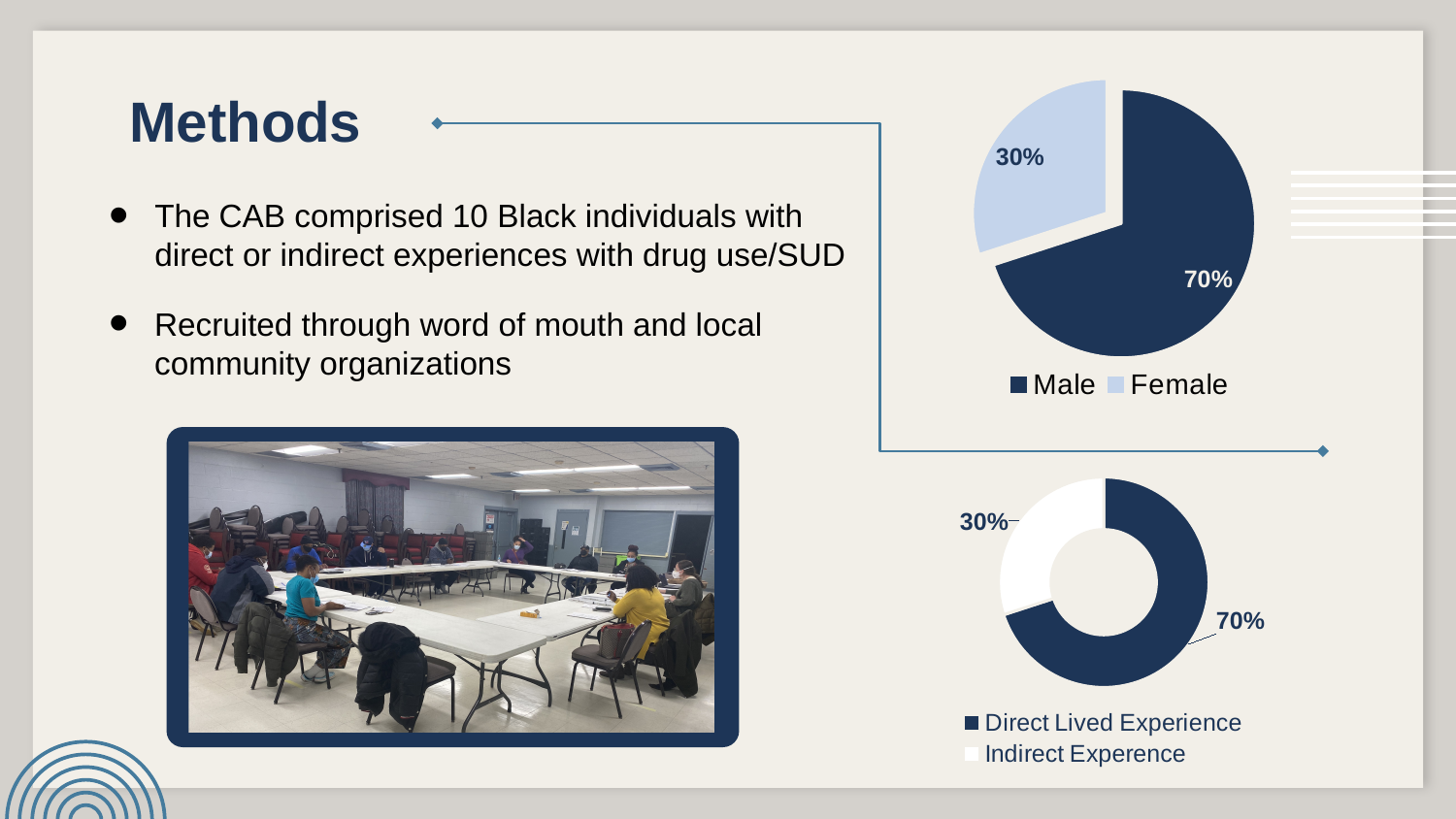
What kind of chart is shown in the bottom-right of the slide? Doughnut chart In the top-right pie chart, what percentage is labelled for Male? 70% How many categories does the bottom-right doughnut chart show? 2 In the top-right pie chart, what percentage is labelled for Female? 30% In the bottom-right doughnut chart, what percentage is labelled for Indirect Experence? 30% In the top-right pie chart, what is the difference in percentage points between Male and Female? 40 In the top-right pie chart, which category has the smaller share? Female How many entries does the legend of the top-right pie chart list? 2 In the bottom-right doughnut chart, what percentage is labelled for Direct Lived Experience? 70% In the top-right pie chart, what colour is the Female slice? Light blue In the bottom-right doughnut chart, which category has the larger share? Direct Lived Experience In the top-right pie chart, which category has the larger share? Male